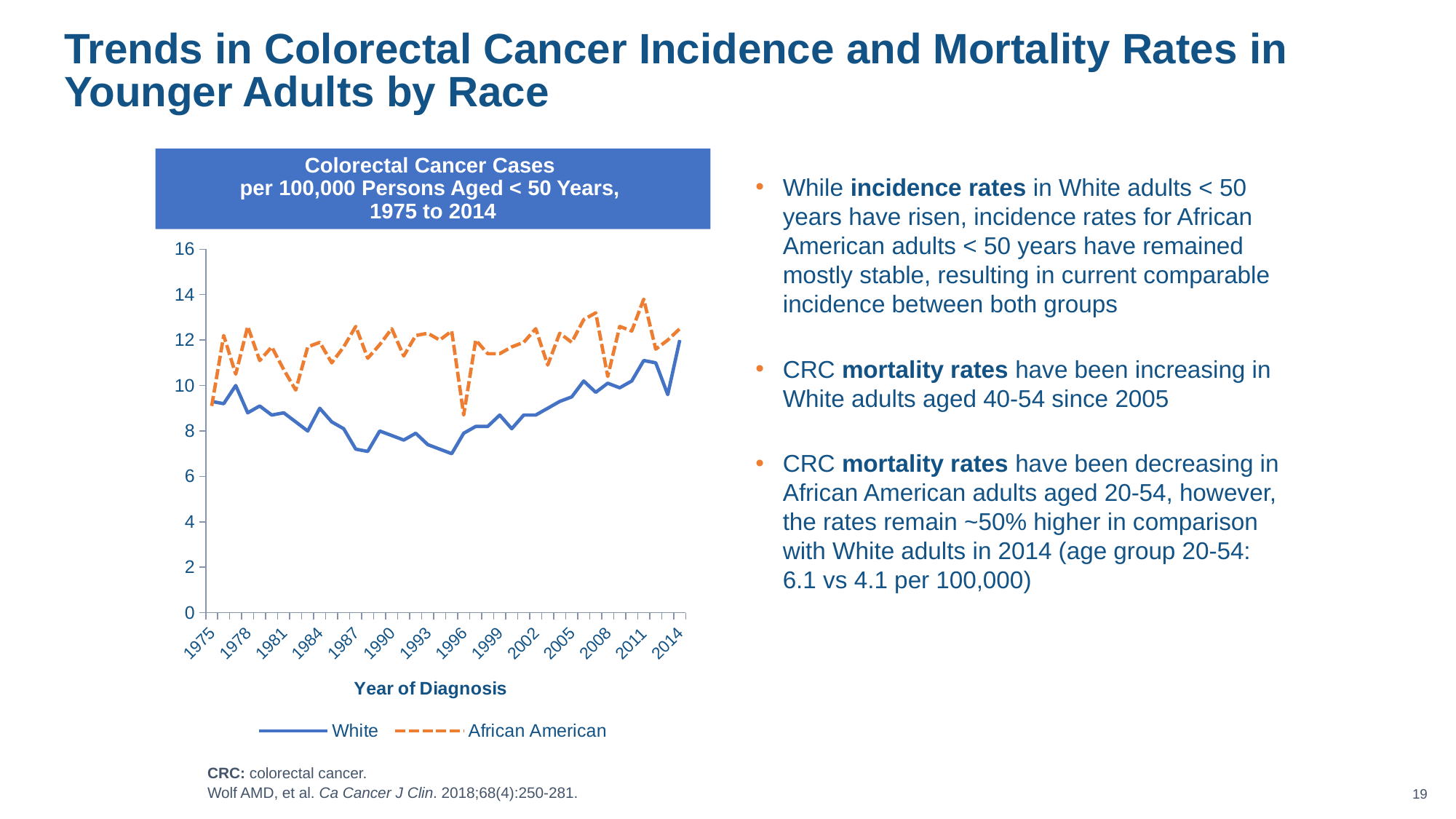
Is the value for African American in 2011 greater or less than 12? greater What is the title of the chart's x axis? Year of Diagnosis What are the two series named in the chart's legend? White and African American Which series reaches the highest value anywhere on the chart? African American Is the value for White in 2014 greater or less than 10? greater In 2005, which series has the higher value, White or African American? African American Is the value for African American in 1996 greater or less than 10? less What kind of chart is shown on the slide? Line chart Does the White series rise or fall between 1996 and 2011? Rise How many series does the chart's legend list? 2 In 1990, which series has the higher value, White or African American? African American